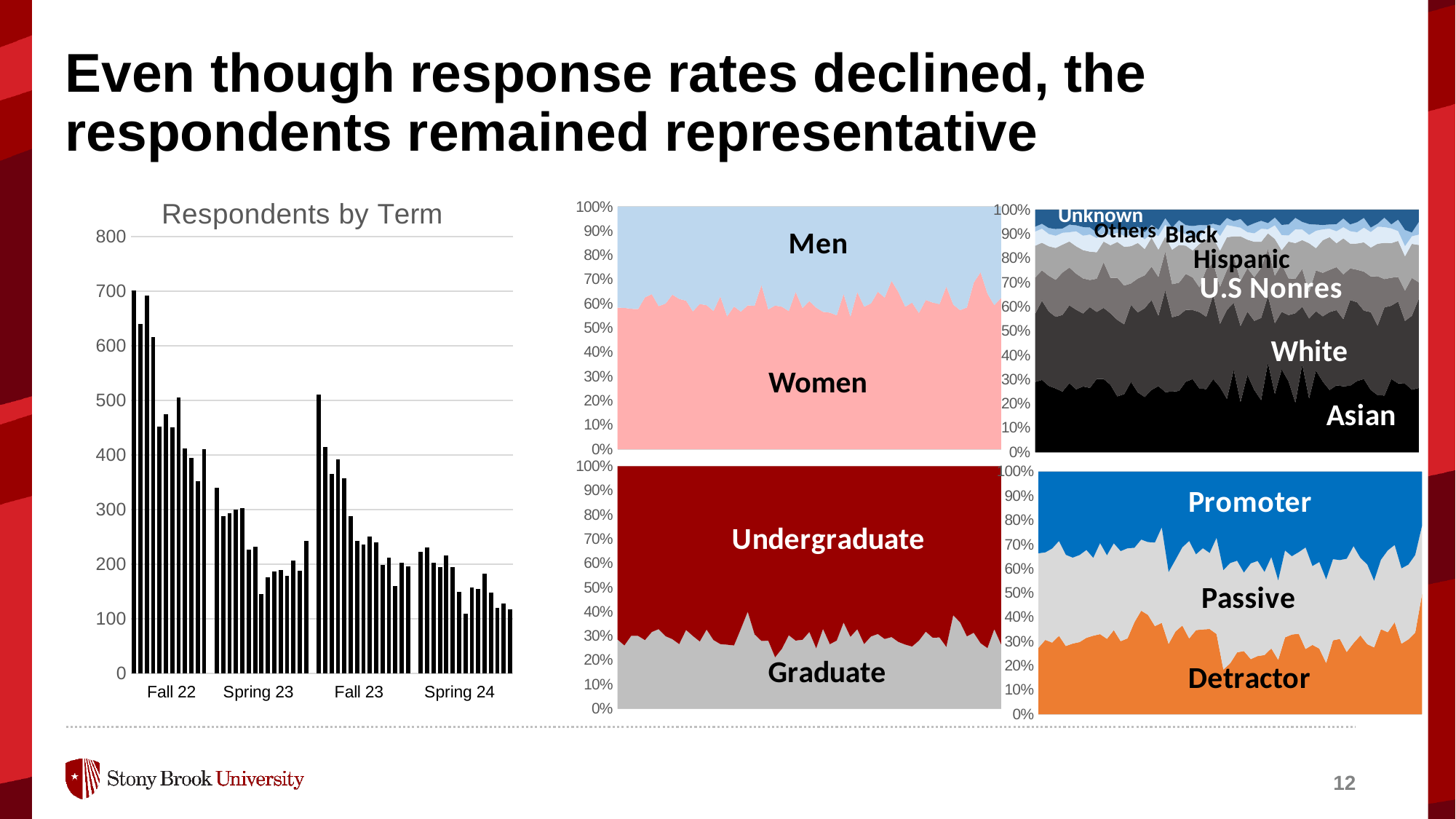
In the Men/Women chart, which group makes up the larger share of respondents? Women In the Undergraduate/Graduate chart, is the Undergraduate share greater or less than 50%? greater In the Promoter/Passive/Detractor chart in the bottom right, which category is shown in blue? Promoter In the 'Respondents by Term' chart, is the first bar of Fall 22 greater or less than 600? greater How many categories are labelled in the race/ethnicity area chart in the top right of the slide? 7 In the 'Respondents by Term' chart, which term contains the tallest bar? Fall 22 In the 'Respondents by Term' chart, is the last bar of Spring 24 greater or less than 200? less How many terms are labelled on the x axis of the 'Respondents by Term' chart? 4 What is the title of the bar chart on the left of the slide? Respondents by Term What kind of chart is the 'Respondents by Term' chart? bar chart In the 'Respondents by Term' chart, do the bar heights generally rise or fall from Fall 22 to Spring 24? fall What kind of chart is the Men/Women chart in the top middle of the slide? area chart